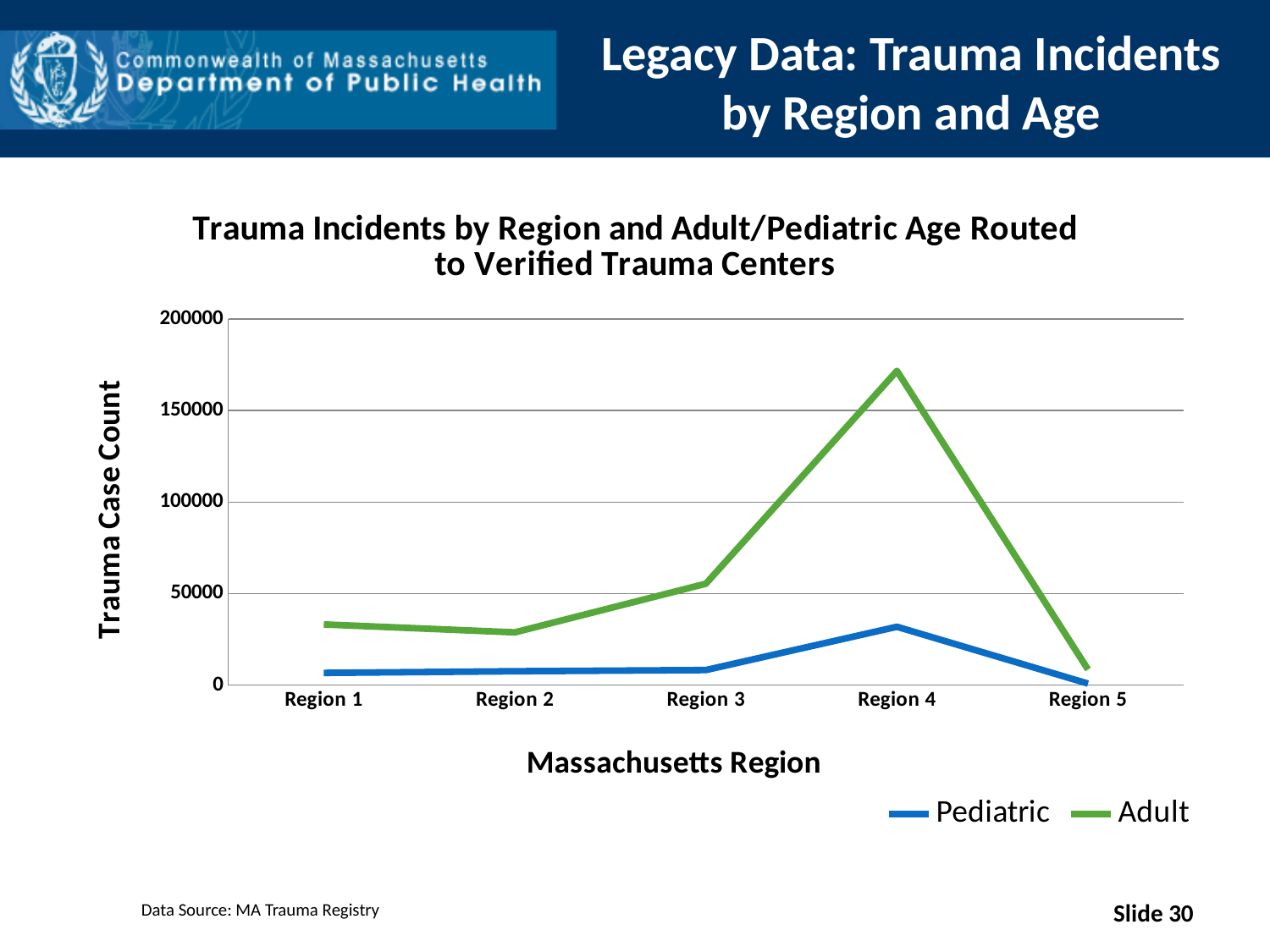
Is the Pediatric value for Region 4 greater or less than 50000? less Is the Adult value for Region 3 greater or less than 50000? greater How many series does the legend list? 2 Is the Adult value for Region 4 greater or less than 150000? greater How many regions are plotted along the x axis? 5 What kind of chart is shown on the slide? Line chart Which region has the highest Pediatric trauma case count? Region 4 Which region has the highest Adult trauma case count? Region 4 In Region 4, which series has the larger value, Pediatric or Adult? Adult What is the label of the y axis? Trauma Case Count What is the label of the x axis? Massachusetts Region Which region has the lowest Adult trauma case count? Region 5